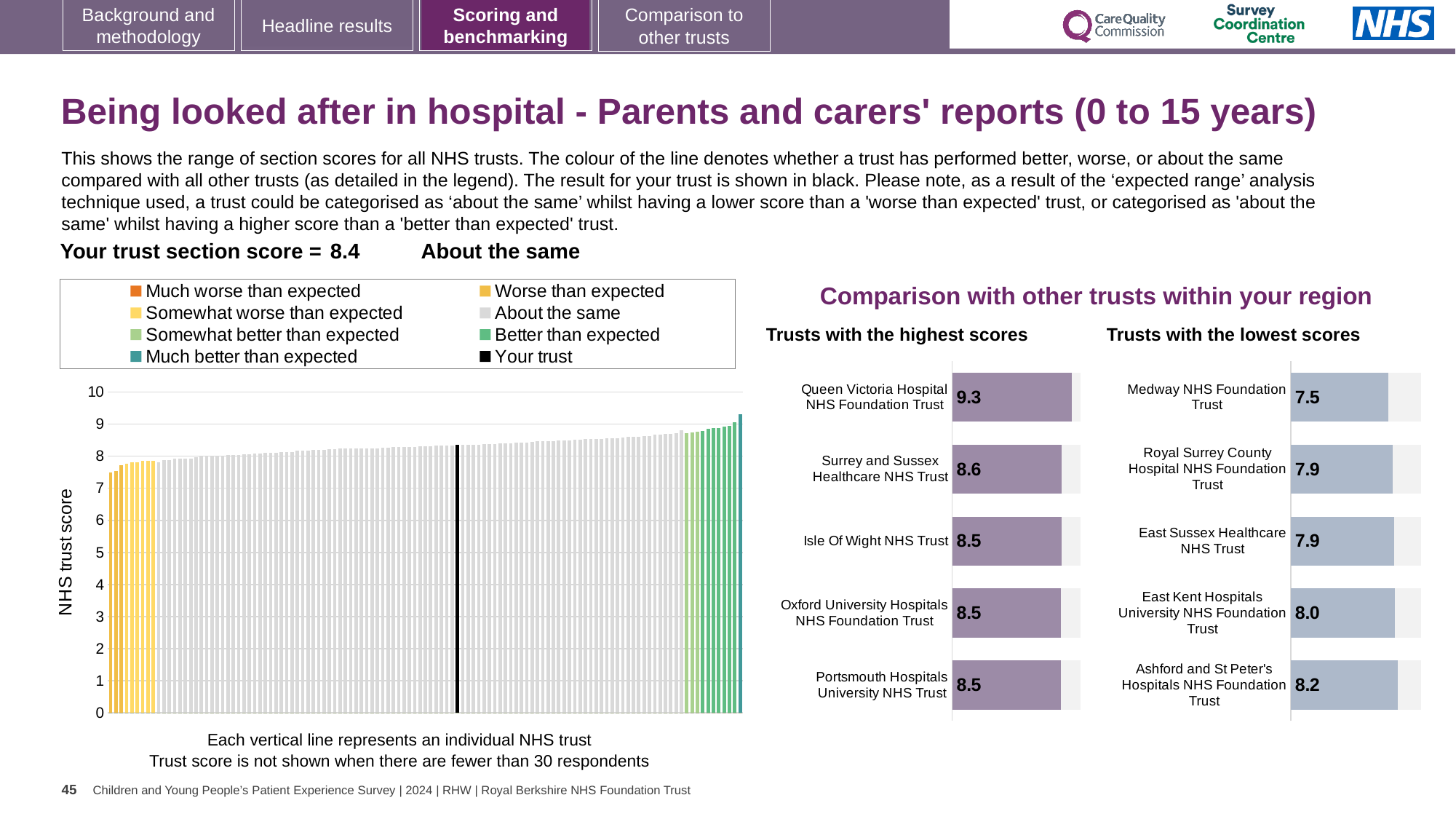
How many entries does the legend of the large chart on the left list? 8 In the 'Trusts with the lowest scores' chart, what is the score for Medway NHS Foundation Trust? 7.5 In the 'Trusts with the lowest scores' chart, which trust has the lowest score? Medway NHS Foundation Trust In the 'Trusts with the lowest scores' chart, what is the difference between the scores of Ashford and St Peter's Hospitals NHS Foundation Trust and Medway NHS Foundation Trust? 0.7 What kind of chart is the 'Trusts with the highest scores' chart? bar chart In the 'Trusts with the highest scores' chart, which trust has the highest score? Queen Victoria Hospital NHS Foundation Trust In the 'Trusts with the highest scores' chart, what is the score for Queen Victoria Hospital NHS Foundation Trust? 9.3 Which is larger: the score for East Kent Hospitals University NHS Foundation Trust in the 'Trusts with the lowest scores' chart or the score for Isle Of Wight NHS Trust in the 'Trusts with the highest scores' chart? Isle Of Wight NHS Trust In the large chart on the left showing all NHS trusts, do the bar values rise or fall from left to right? rise In the large chart on the left showing all NHS trusts, is the value of the black bar for your trust greater or less than 8? greater How many trusts are shown in the 'Trusts with the lowest scores' chart? 5 In the 'Trusts with the highest scores' chart, what is the difference between the scores of Queen Victoria Hospital NHS Foundation Trust and Surrey and Sussex Healthcare NHS Trust? 0.7